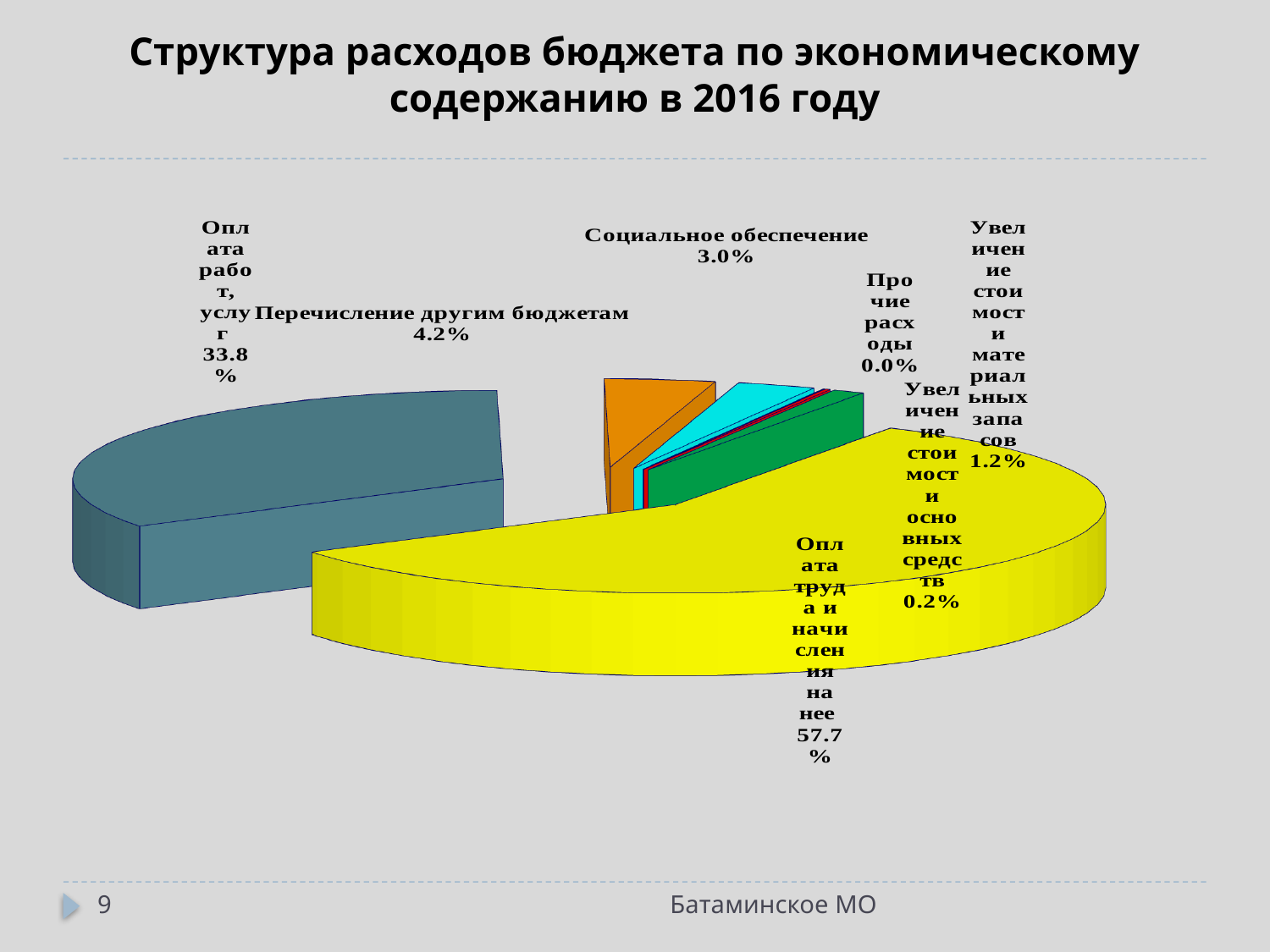
What is the share for "Увеличение стоимости материальных запасов"? 1.2% What is the share for "Оплата работ, услуг"? 33.8% What is the share for "Оплата труда и начисления на нее"? 57.7% How many categories are shown in the pie chart? 7 What is the share for "Прочие расходы"? 0.0% Which is larger: the share for "Перечисление другим бюджетам" or for "Социальное обеспечение"? Перечисление другим бюджетам What is the share for "Социальное обеспечение"? 3.0% What is the share for "Перечисление другим бюджетам"? 4.2% What is the difference in percentage points between "Оплата труда и начисления на нее" and "Оплата работ, услуг"? 23.9 Which category has the smallest share of the pie? Прочие расходы What kind of chart is shown on the slide? pie chart Which category has the largest share of the pie? Оплата труда и начисления на нее